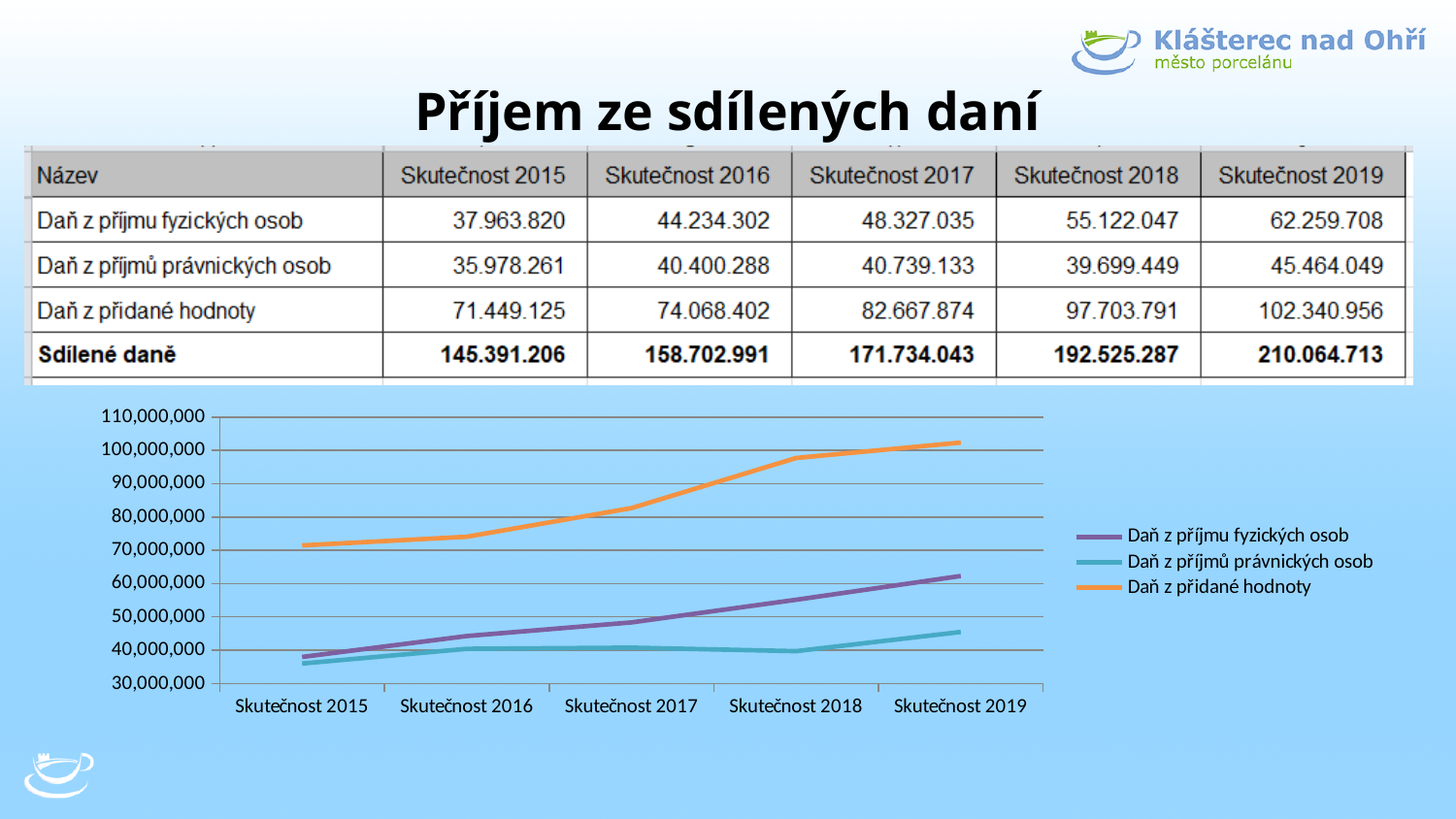
Is the value for Daň z příjmu fyzických osob at Skutečnost 2016 greater or less than 50,000,000? less How many series does the chart legend list? 3 Is the value for Daň z přidané hodnoty at Skutečnost 2018 greater or less than 90,000,000? greater How many points along the x axis does each line in the chart have? 5 Which series has the highest value at Skutečnost 2019 in the chart? Daň z přidané hodnoty According to the table, what is the value of Daň z příjmu fyzických osob for Skutečnost 2015? 37.963.820 In which year is the value of Daň z přidané hodnoty lowest in the chart? Skutečnost 2015 According to the table, what is the value of Daň z přidané hodnoty for Skutečnost 2019? 102.340.956 What colour is the line for Daň z přidané hodnoty in the chart? orange According to the table, by how much did Sdílené daně increase from Skutečnost 2015 to Skutečnost 2019? 64.673.507 Does the line for Daň z příjmu fyzických osob rise or fall from Skutečnost 2015 to Skutečnost 2019? rise What kind of chart is shown on the slide? line chart